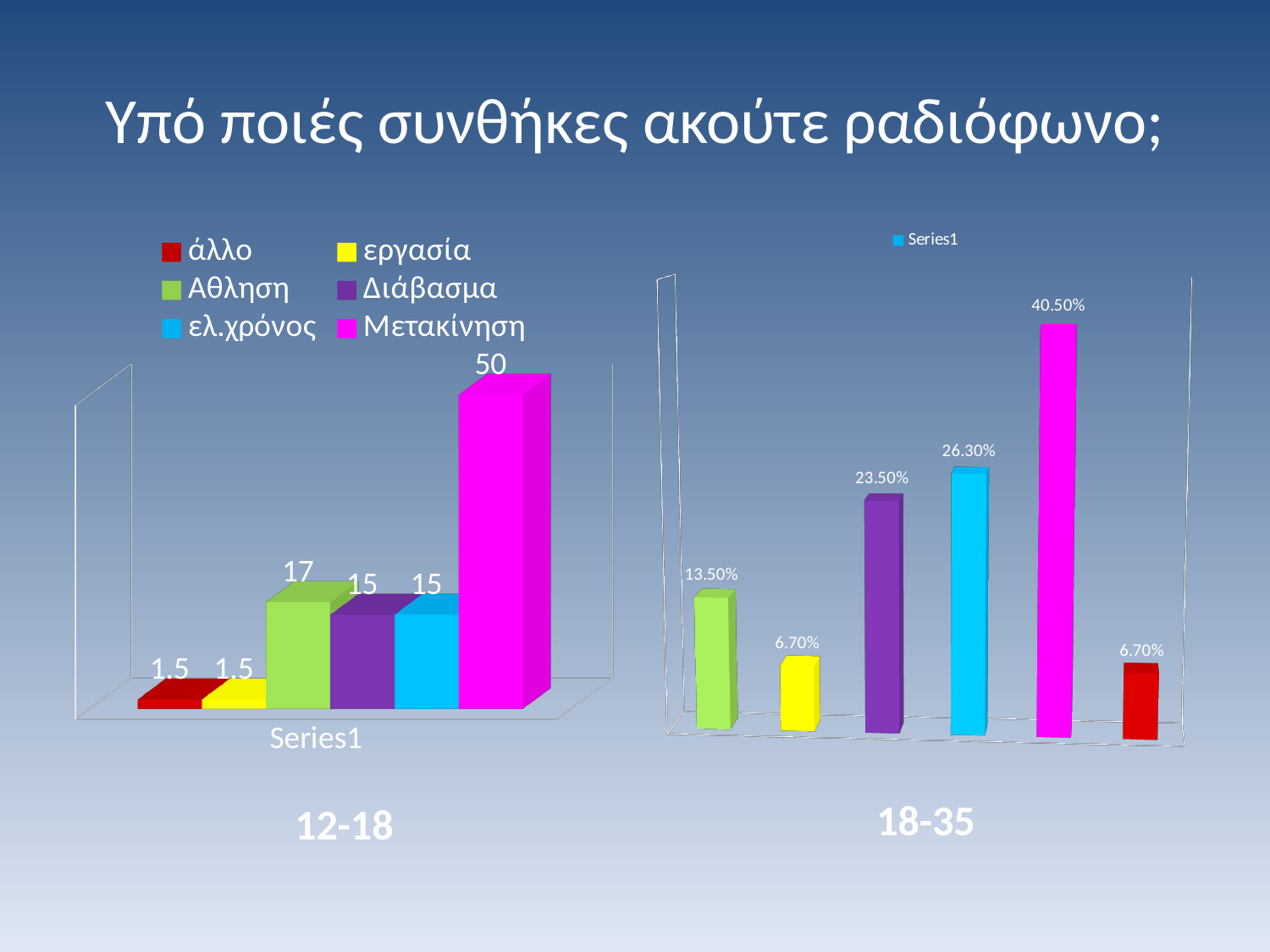
In the 12-18 chart, what is the value for Μετακίνηση? 50 In the 12-18 chart, how many categories does the legend list? 6 In the 18-35 chart, what is the difference between the values on the purple bar and the green bar? 10.00% In the 12-18 chart, what colour is the bar for ελ.χρόνος? Cyan (light blue) In the 12-18 chart, what is the difference between the values for Μετακίνηση and Άθληση? 33 In the 12-18 chart, what is the value for Άθληση? 17 In the 18-35 chart, how many bars are plotted? 6 In the 18-35 chart, what is the value shown on the tallest (magenta) bar? 40.50% In the 12-18 chart, which is larger, the value for Άθληση or the value for Διάβασμα? Άθληση In the 12-18 chart, which category has the highest value? Μετακίνηση What kind of chart is the 18-35 chart? Bar chart In the 18-35 chart, what is the value shown on the cyan bar? 26.30%